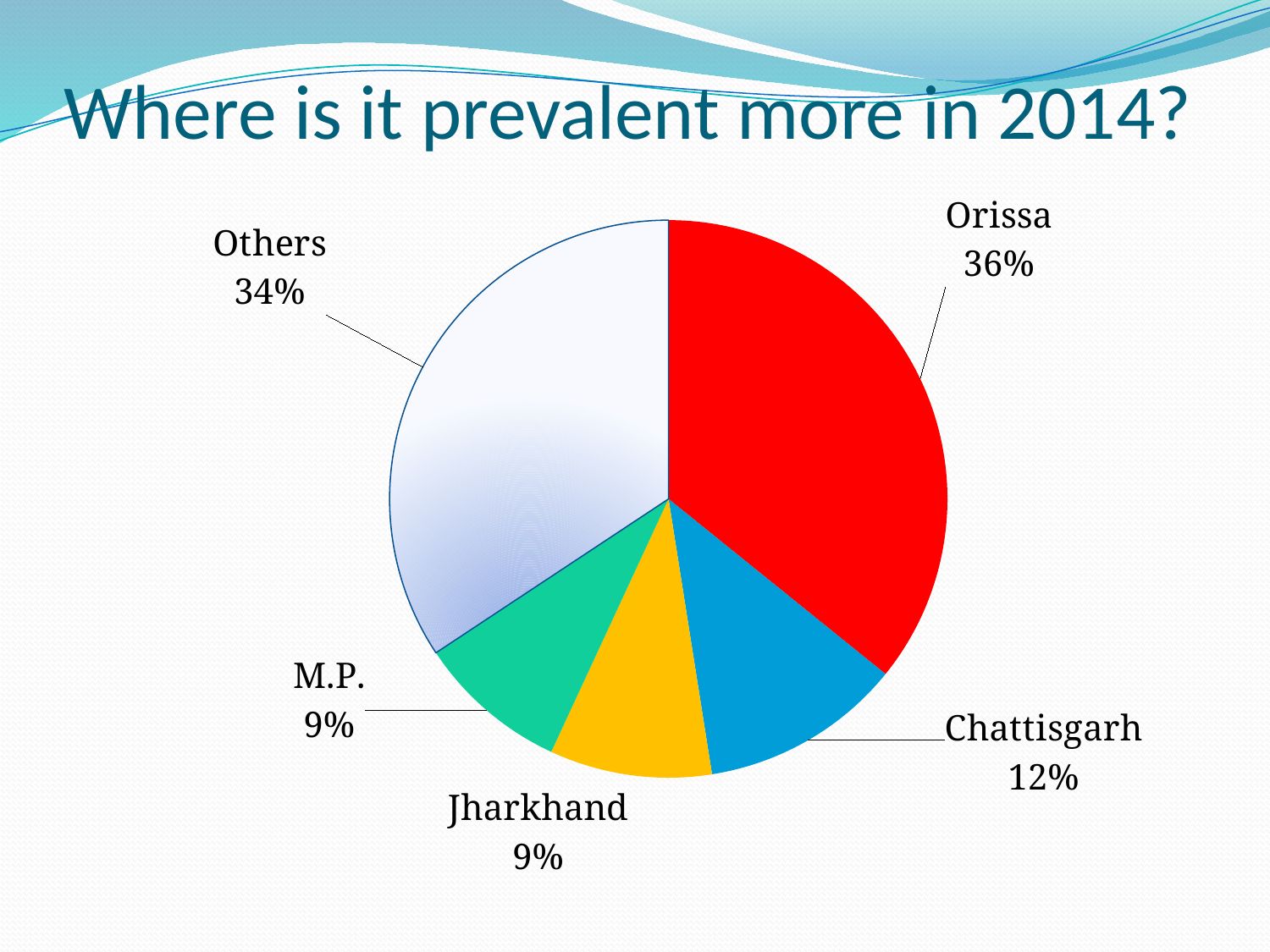
What is the difference between the shares of Others and Jharkhand? 25% How many slices does the pie chart have? 5 What is the value for Others? 34% Which is larger, the share for Chattisgarh or the share for M.P.? Chattisgarh What colour is the slice for Orissa? red What is the title of the slide containing the pie chart? Where is it prevalent more in 2014? What is the value for Chattisgarh? 12% Which category has the largest slice of the pie? Orissa What share of the pie does Orissa have? 36% What is the value for Jharkhand? 9% What is the difference between the shares of Orissa and Chattisgarh? 24% What kind of chart is shown on the slide? pie chart